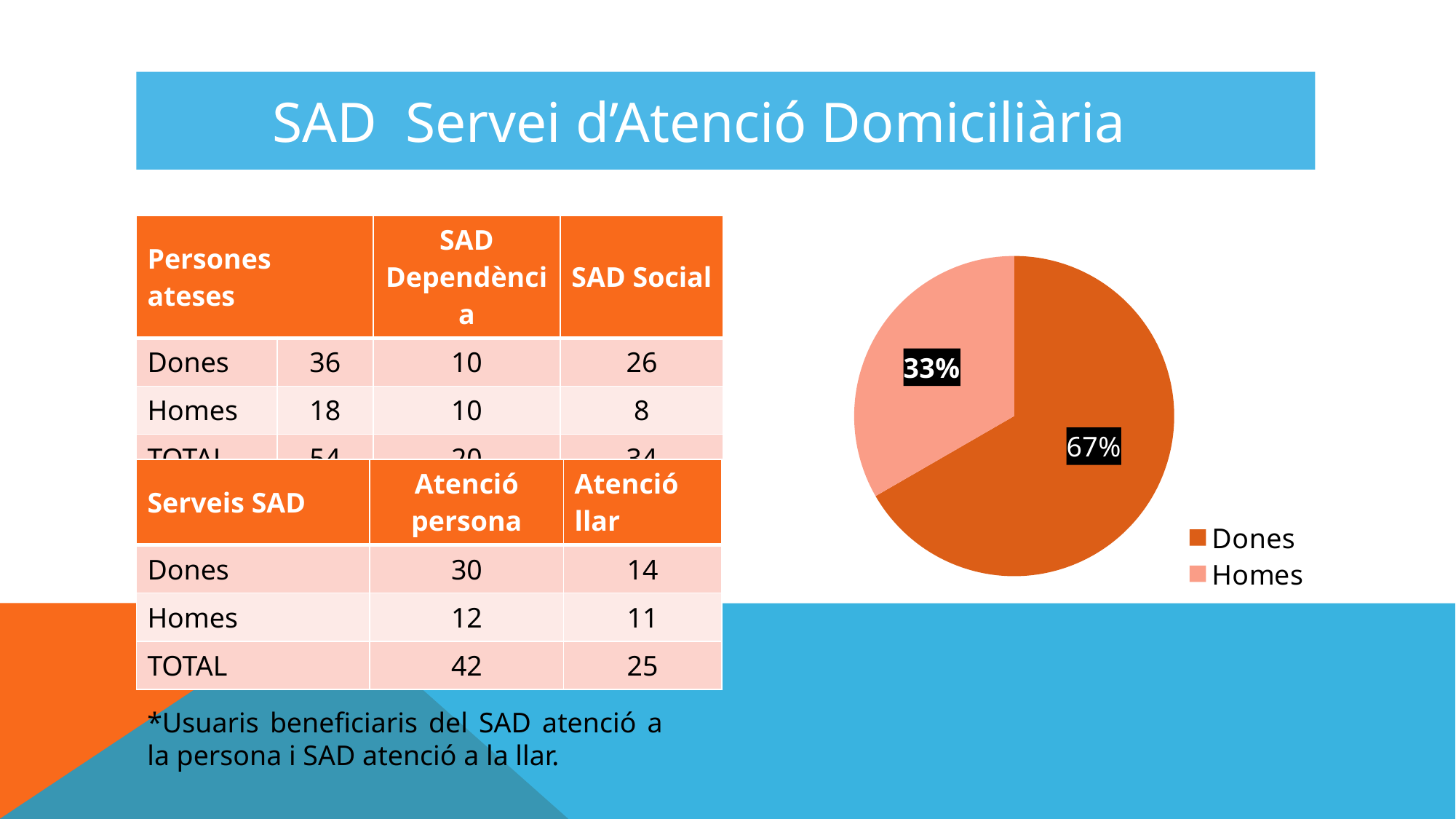
What percentage of the pie chart does the Homes slice represent? 33% What percentage of the pie chart does the Dones slice represent? 67% What share of the pie chart is taken by Homes? 33% Which is larger in the pie chart, the Dones slice or the Homes slice? Dones Which legend entry in the pie chart is shown in the lighter salmon colour? Homes How many slices does the pie chart have? 2 Which slice of the pie chart is the smallest? Homes Which legend entry in the pie chart is shown in the darker orange colour? Dones How many entries does the pie chart's legend list? 2 By how many percentage points does the Dones slice exceed the Homes slice in the pie chart? 34 Which slice of the pie chart is the largest? Dones What kind of chart is shown on the slide? pie chart